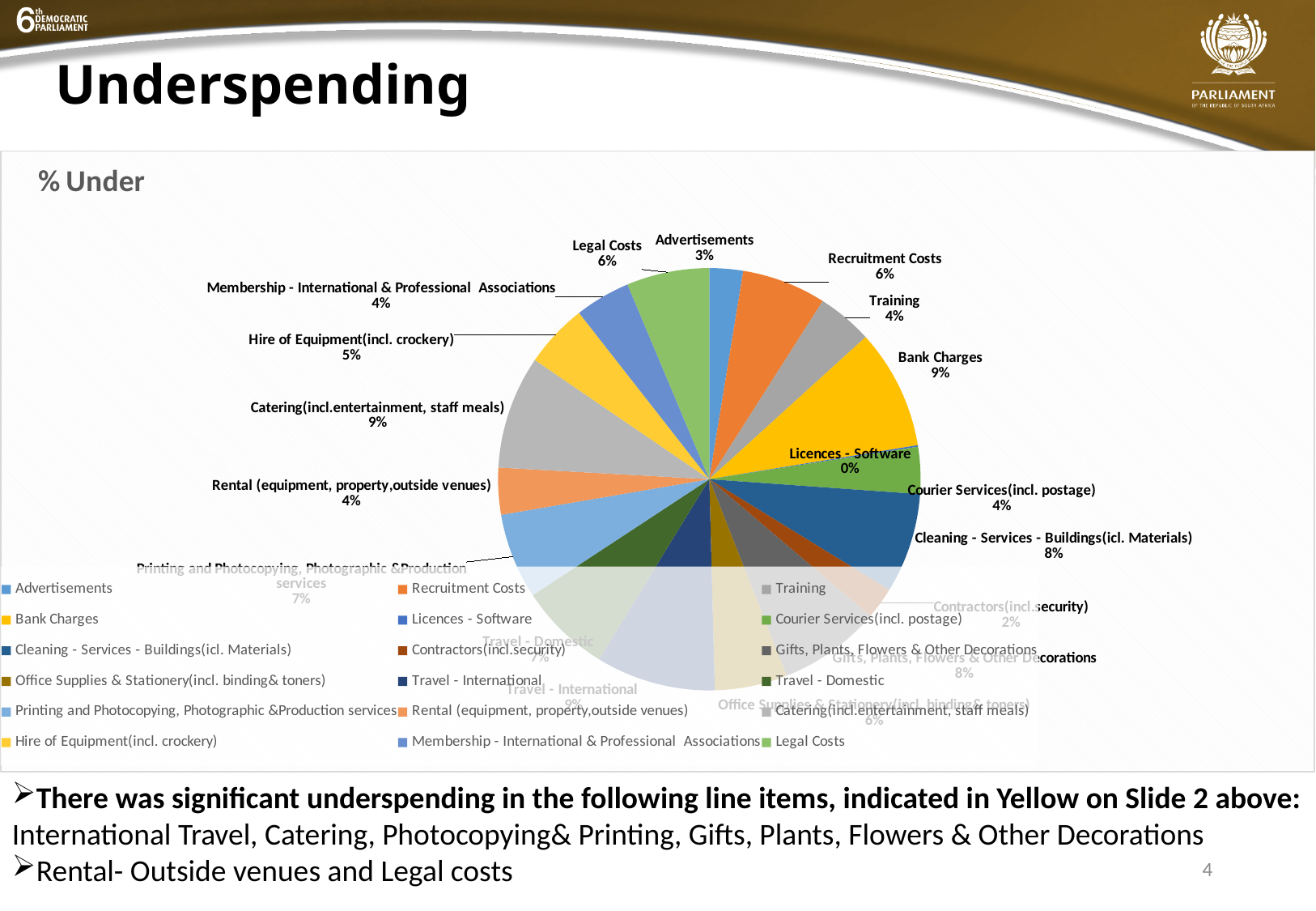
What is the value shown for Contractors(incl.security)? 2% What is the value shown for Advertisements? 3% Which category has the smallest share of the pie? Licences - Software What is the difference between the Legal Costs share and the Advertisements share? 3% What type of chart is shown on the slide? pie chart What percentage does the Bank Charges slice represent? 9% What is the title of the chart? % Under Which is larger, the share for Catering(incl.entertainment, staff meals) or the share for Rental (equipment, property,outside venues)? Catering(incl.entertainment, staff meals) What is the value for Hire of Equipment(incl. crockery)? 5% How many categories does the legend list? 18 What percentage is shown for Cleaning - Services - Buildings(icl. Materials)? 8% What is the difference between the Recruitment Costs share and the Training share? 2%